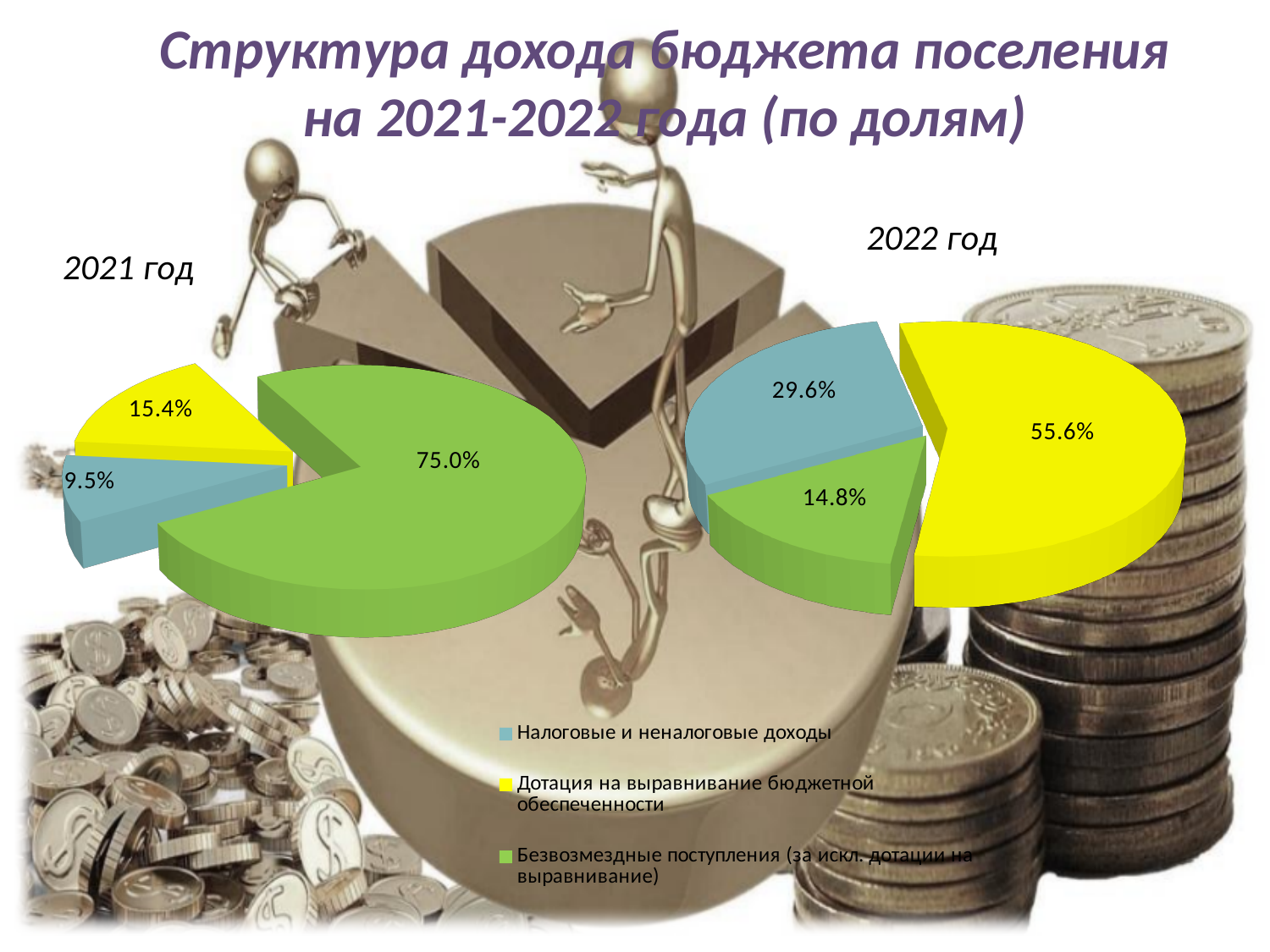
In the 2022 год pie chart, what share is shown for Налоговые и неналоговые доходы? 29.6% In the 2022 год pie chart, what share is shown for Дотация на выравнивание бюджетной обеспеченности? 55.6% Which colour represents Безвозмездные поступления (за искл. дотации на выравнивание) in the legend? Green In the 2022 год pie chart, what is the difference between the shares of Дотация на выравнивание бюджетной обеспеченности and Налоговые и неналоговые доходы? 26.0% In the 2022 год pie chart, which category has the largest share? Дотация на выравнивание бюджетной обеспеченности How many categories does the legend list for the pie charts? 3 In the 2021 год pie chart, what share is shown for Налоговые и неналоговые доходы? 9.5% Which is larger: the share of Налоговые и неналоговые доходы in the 2021 год chart or in the 2022 год chart? 2022 год In the 2021 год pie chart, which category has the smallest share? Налоговые и неналоговые доходы In the 2021 год pie chart, what share is shown for Безвозмездные поступления (за искл. дотации на выравнивание)? 75.0% What type of chart is used for 2021 год and 2022 год? Pie chart In the 2021 год pie chart, what share is shown for Дотация на выравнивание бюджетной обеспеченности? 15.4%